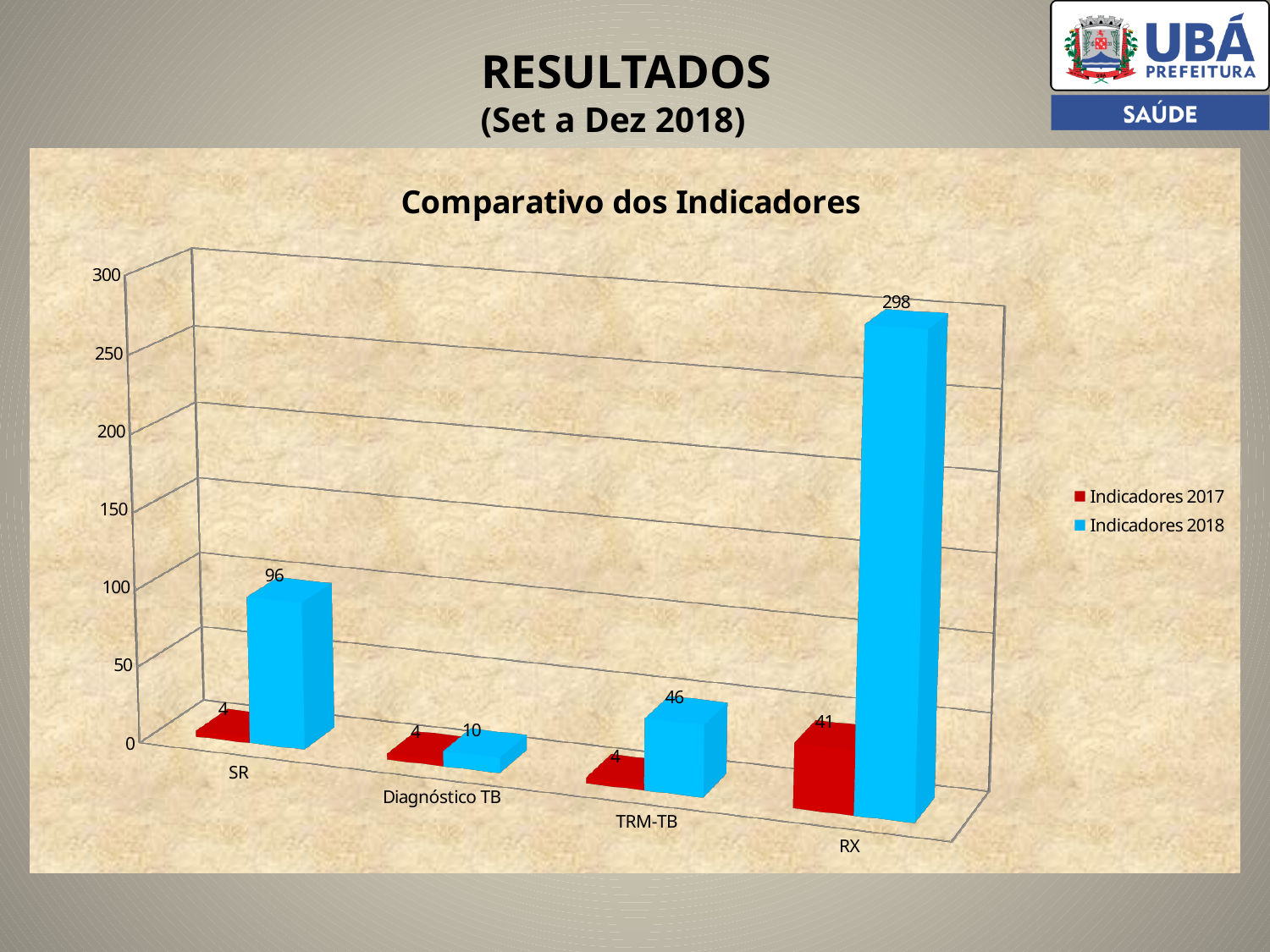
Which category has the highest value for Indicadores 2018? RX What is the value for Indicadores 2018 in the SR category? 96 What is the difference between Indicadores 2018 and Indicadores 2017 in the RX category? 257 What is the value for Indicadores 2018 in the RX category? 298 What kind of chart is shown on the slide? bar chart How many categories are shown on the x axis? 4 Is the value for Indicadores 2018 in the RX category greater or less than 250? greater Which is larger: Indicadores 2018 for SR or Indicadores 2018 for TRM-TB? SR What is the value for Indicadores 2017 in the RX category? 41 What is the value for Indicadores 2018 in the TRM-TB category? 46 How many series does the legend list? 2 Which category has the lowest value for Indicadores 2018? Diagnóstico TB